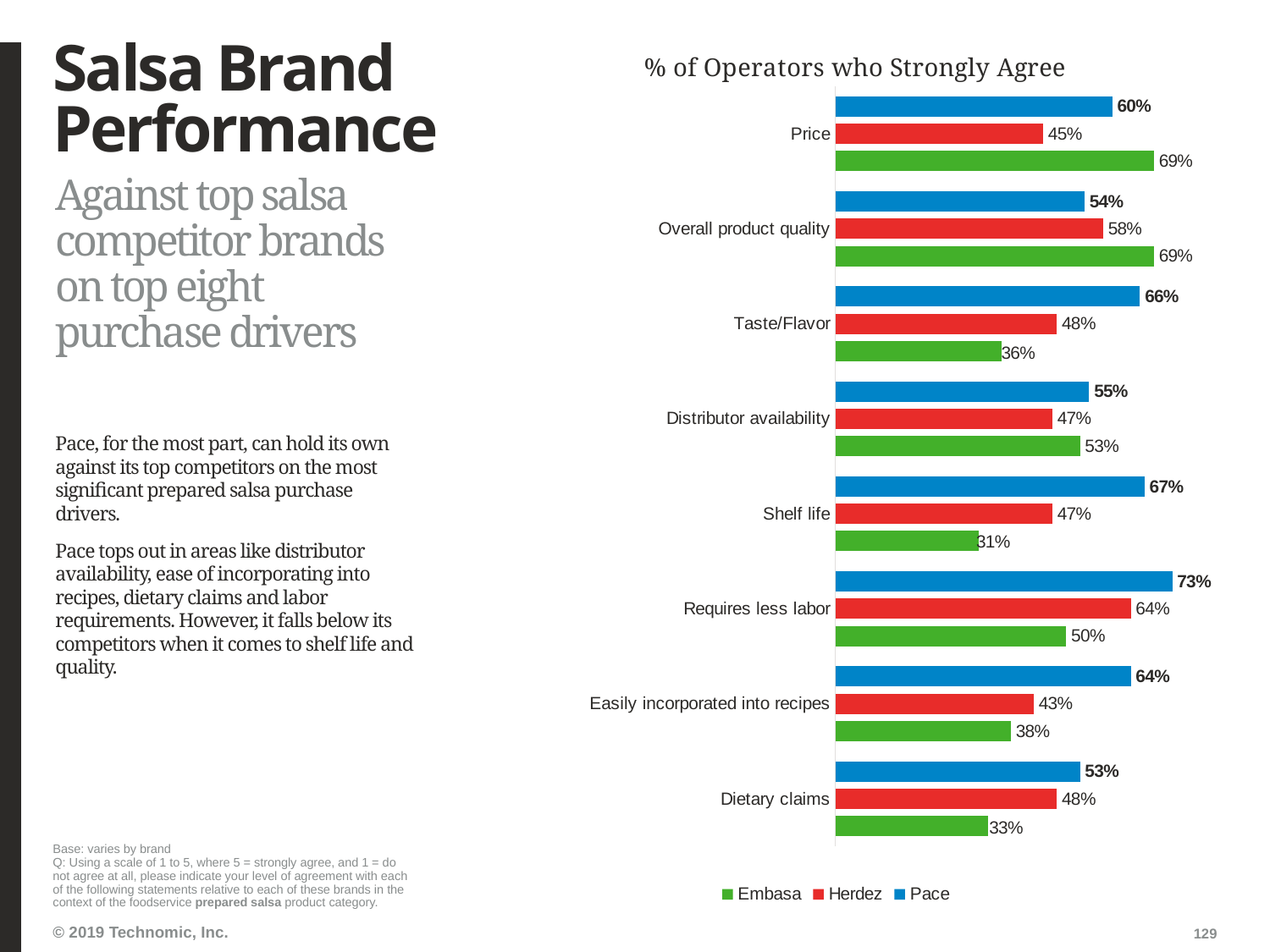
What percentage of operators strongly agree with Pace on Price? 60% What is the value for Herdez on Overall product quality? 58% What is the value for Embasa on Shelf life? 31% How many brands does the legend list? 3 What is the title of the chart? % of Operators who Strongly Agree What is the difference between Pace and Herdez on Easily incorporated into recipes? 21 percentage points Which brand has the larger value on Price, Embasa or Herdez? Embasa How many purchase driver categories are shown in the chart? 8 Which brand has the larger value on Taste/Flavor, Pace or Embasa? Pace Which category has the lowest value for Embasa? Shelf life Which category has the highest value for Pace? Requires less labor What type of chart is shown on the slide? Bar chart